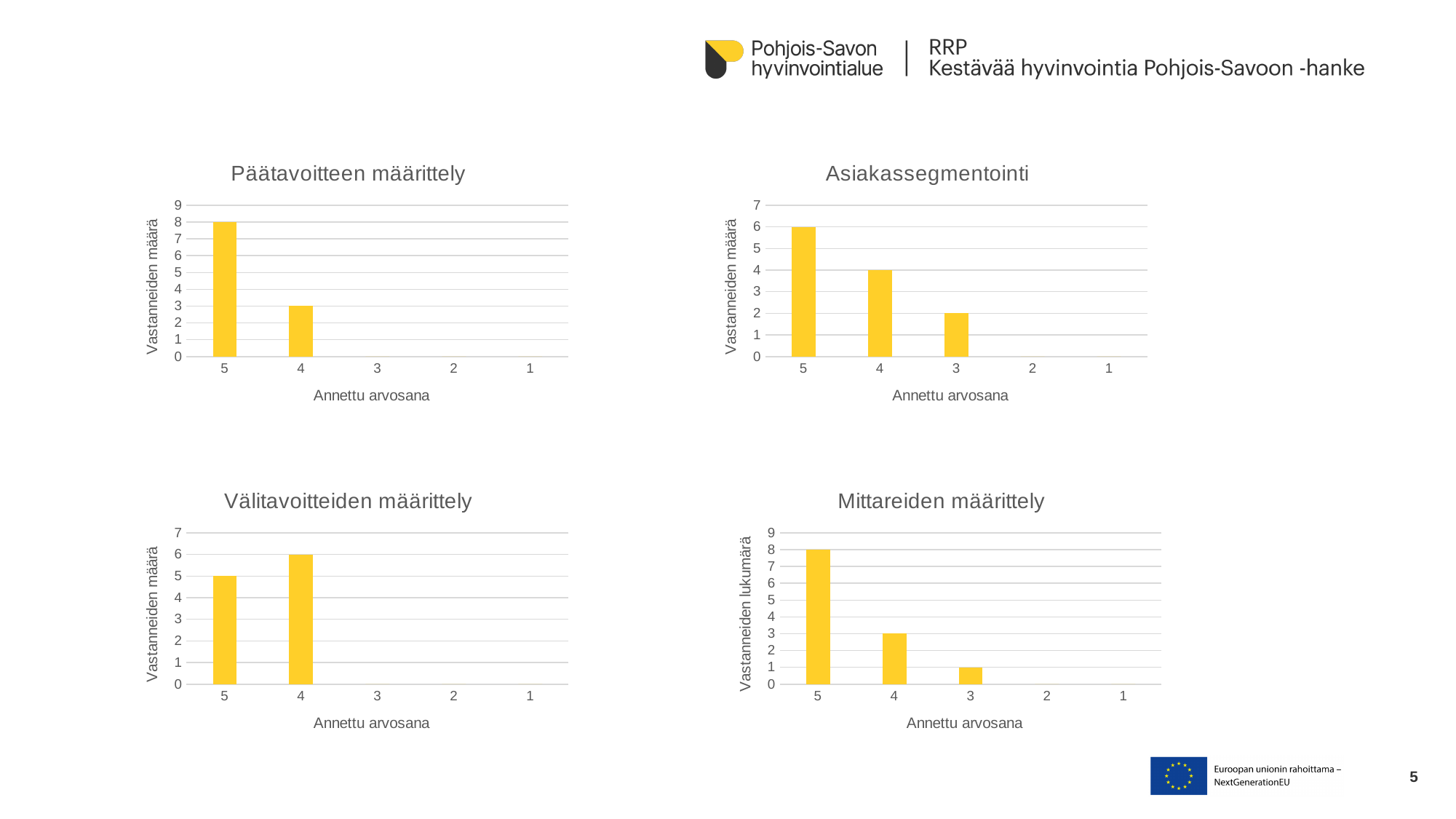
What type of chart is 'Päätavoitteen määrittely'? bar chart In the 'Asiakassegmentointi' chart, what is the difference between the number of responses for rating 5 and rating 4? 2 In the 'Mittareiden määrittely' chart, how many respondents gave a rating of 3? 1 In the 'Päätavoitteen määrittely' chart, how many respondents gave a rating of 4? 3 In the 'Mittareiden määrittely' chart, what is the difference between the number of responses for rating 5 and rating 4? 5 How many rating categories are shown on the x axis of the 'Asiakassegmentointi' chart? 5 In the 'Asiakassegmentointi' chart, which rating received the most responses? 5 In the 'Mittareiden määrittely' chart, do the values rise or fall as the rating goes from 5 to 3 along the x axis? fall In the 'Asiakassegmentointi' chart, how many respondents gave a rating of 3? 2 In the 'Päätavoitteen määrittely' chart, how many respondents gave a rating of 5? 8 In the 'Välitavoitteiden määrittely' chart, how many respondents gave a rating of 5? 5 In the 'Välitavoitteiden määrittely' chart, which rating received more responses, 5 or 4? 4